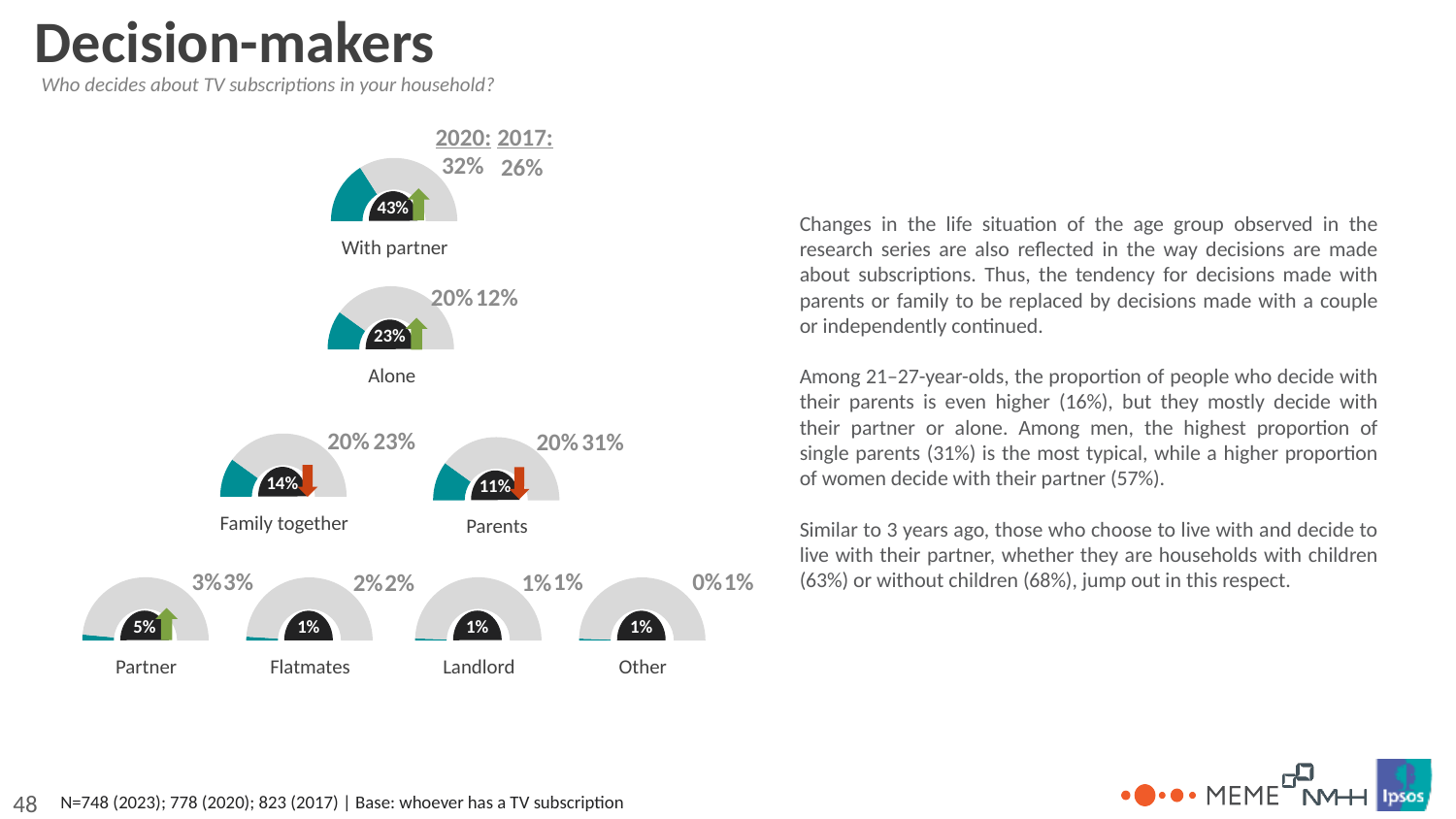
How many gauge charts (categories) are shown on the slide? 8 Which is larger: the current value in the 'Alone' gauge chart or the current value in the 'Family together' gauge chart? Alone In the 'Family together' gauge chart, does the arrow indicate the value rose or fell compared with earlier years? fell In the 'Alone' gauge chart, what is the 2017 value shown? 12% In the 'Parents' gauge chart, what is the difference between the 2017 value and the current value? 20% In the 'Family together' gauge chart, what is the 2017 value shown? 23% What two earlier years are shown as comparison columns above the 'With partner' gauge chart? 2020 and 2017 Across the gauge charts, which category has the highest current (centre) value? With partner In the 'Partner' gauge chart, what is the current value shown in the centre? 5% In the 'With partner' gauge chart, what is the difference between the current value and the 2020 value? 11% In the 'With partner' gauge chart, what is the current value shown in the centre? 43% In the 'Parents' gauge chart, what is the 2020 value shown? 20%